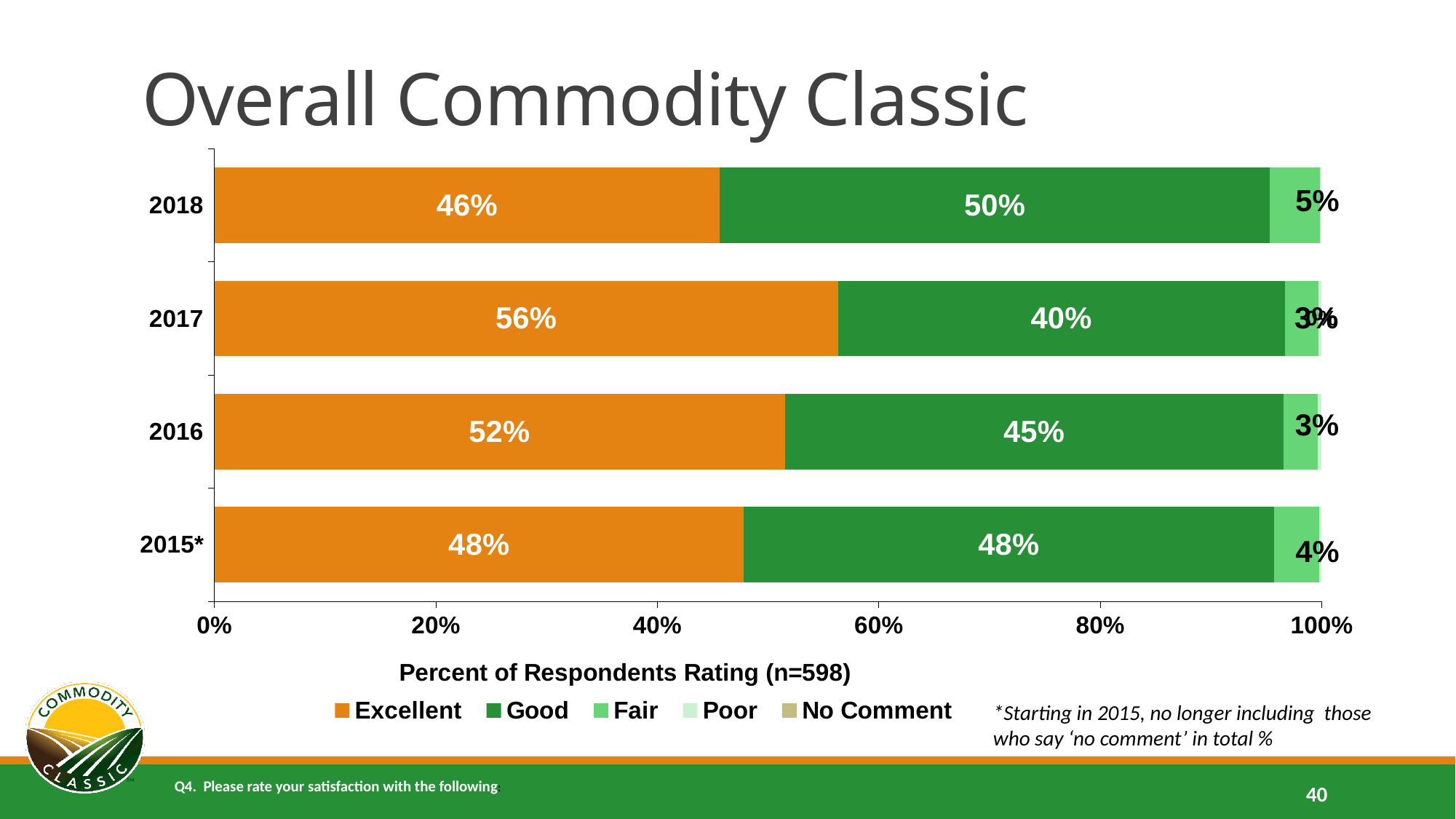
What is the difference between the Excellent percentages for 2017 and 2018? 10% How many series does the legend list? 5 What is the x-axis title of the chart? Percent of Respondents Rating (n=598) What type of chart is shown on the slide? Stacked bar chart Which year has the highest Excellent percentage? 2017 What percentage of respondents rated the Overall Commodity Classic as Excellent in 2018? 46% Which year has the lowest Excellent percentage? 2018 What is the Excellent percentage for 2015*? 48% Is the Good percentage larger in 2018 or in 2016? 2018 What percentage of respondents rated the Overall Commodity Classic as Good in 2017? 40% How many years are shown on the chart? 4 What is the Fair percentage for 2018? 5%